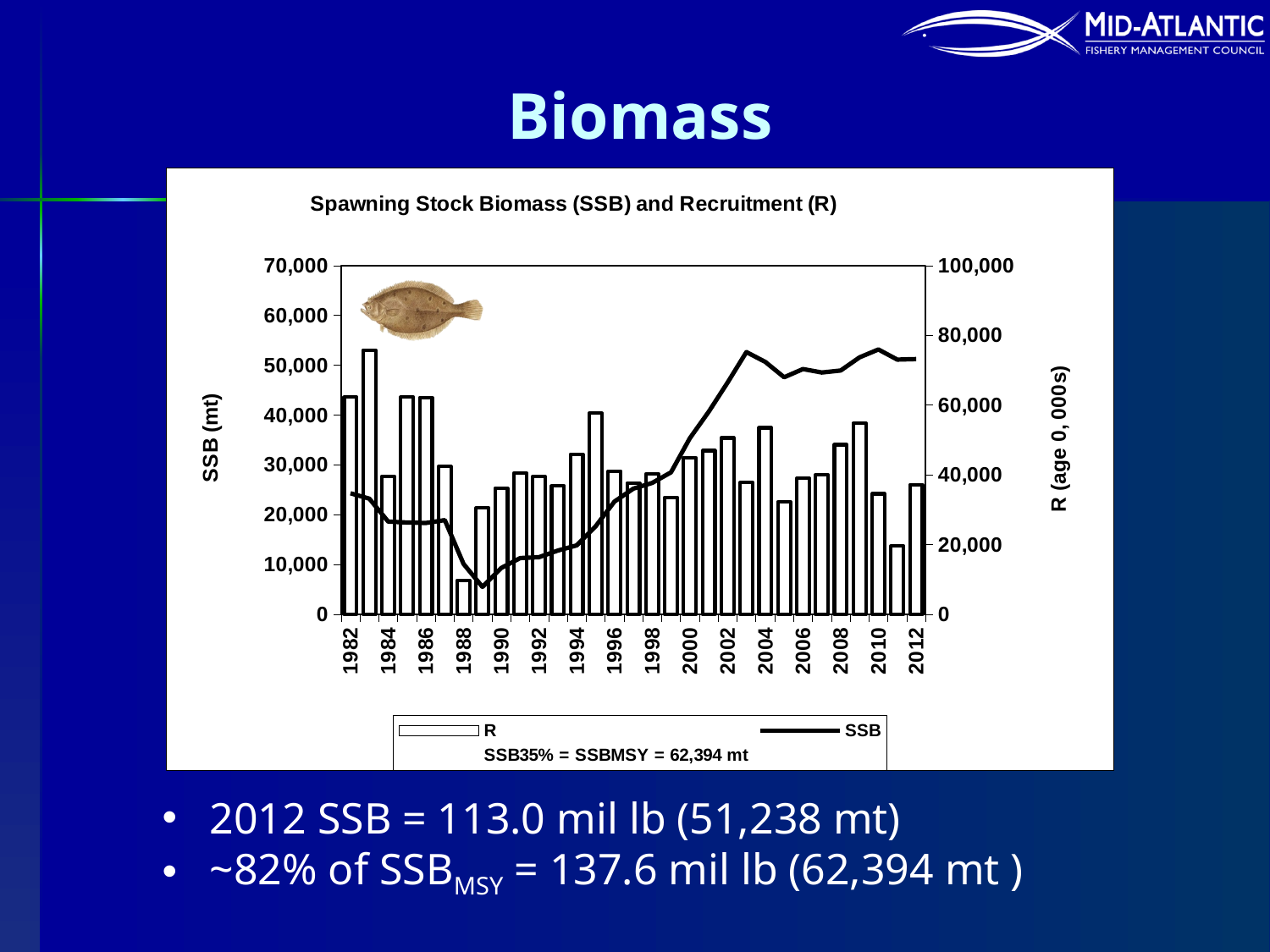
In which year is the SSB line at its lowest? 1989 How many years are plotted on the x axis, from 1982 to 2012? 31 Is the R value for 1983 greater or less than 60,000 on the right axis? greater Which year has the larger R bar, 1983 or 1995? 1983 In which year is the R (recruitment) bar the shortest? 1988 What is the title of the chart? Spawning Stock Biomass (SSB) and Recruitment (R) How many series does the chart legend list? 3 What are the two series named in the legend? R and SSB In which year is the R (recruitment) bar the tallest? 1983 What kind of chart is shown on the slide? A combined bar and line chart Is the SSB value for 1989 greater or less than 10,000 mt? less Does the SSB line rise or fall between 1989 and 2003? rise